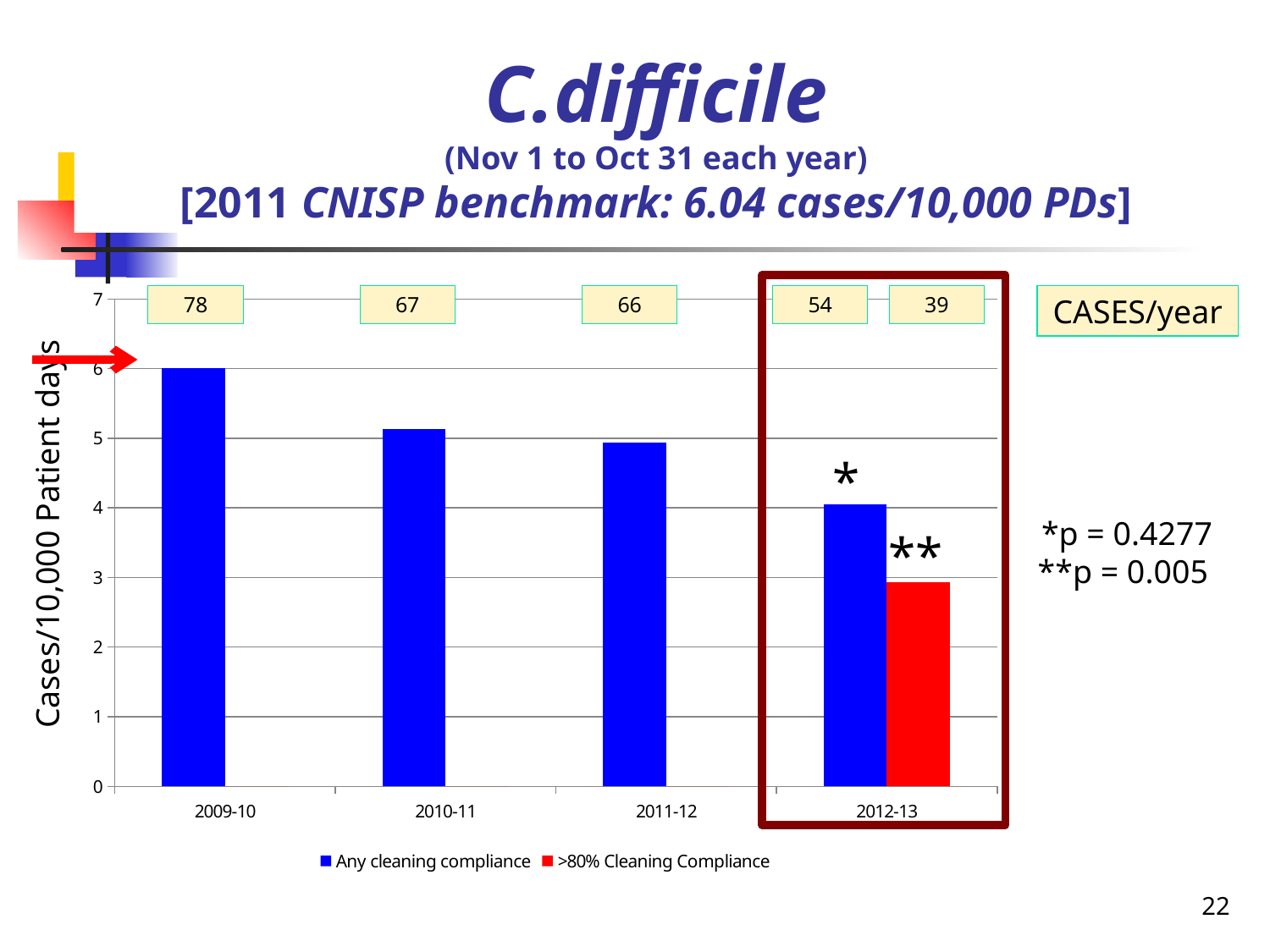
What kind of chart is shown on the slide? bar chart Which year has the lowest 'Any cleaning compliance' bar? 2012-13 In 2012-13, which bar is taller: 'Any cleaning compliance' or '>80% Cleaning Compliance'? Any cleaning compliance What is the label of the y axis of the chart? Cases/10,000 Patient days Which series is shown in red in the chart? >80% Cleaning Compliance Do the blue 'Any cleaning compliance' bars rise or fall from 2009-10 to 2012-13? fall How many year categories are shown on the x axis of the chart? 4 Is the '>80% Cleaning Compliance' value for 2012-13 greater or less than 4? less How many series does the chart legend list? 2 Is the 'Any cleaning compliance' value for 2010-11 greater or less than 6? less According to the CASES/year boxes above the chart, how many cases were there in 2009-10? 78 Which year has the highest 'Any cleaning compliance' bar? 2009-10